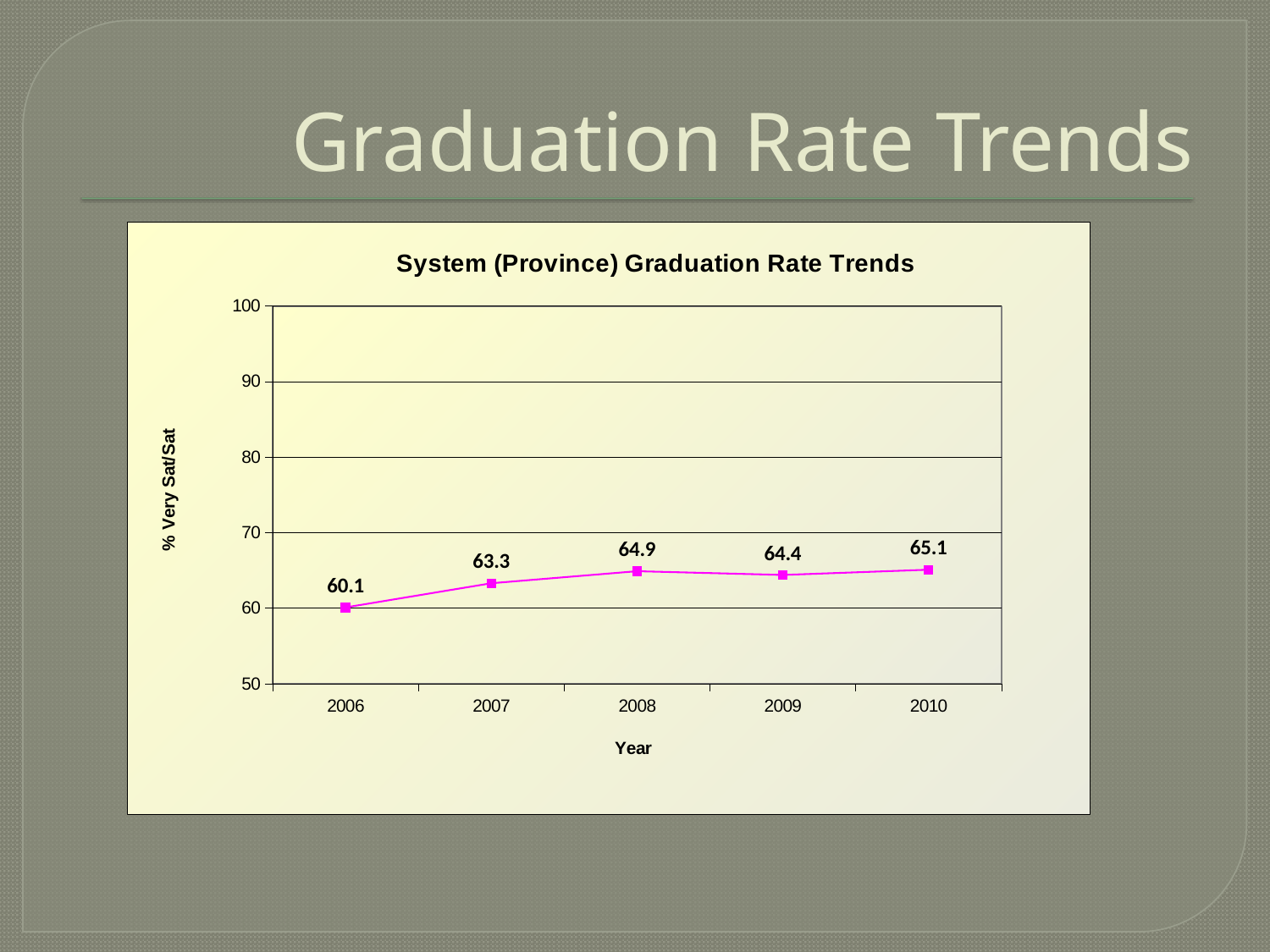
What is the title of the chart? System (Province) Graduation Rate Trends What is the difference between the 2008 value and the 2009 value? 0.5 Which year has the lowest graduation rate? 2006 What kind of chart is shown on the slide? line chart What is the graduation rate value for 2006? 60.1 Is the value for 2007 greater or less than 70? less Which year has a larger value, 2007 or 2009? 2009 What is the graduation rate value for 2008? 64.9 How many years are plotted on the chart? 5 Which year has the highest graduation rate? 2010 What is the graduation rate value for 2010? 65.1 What is the difference between the 2010 value and the 2006 value? 5.0